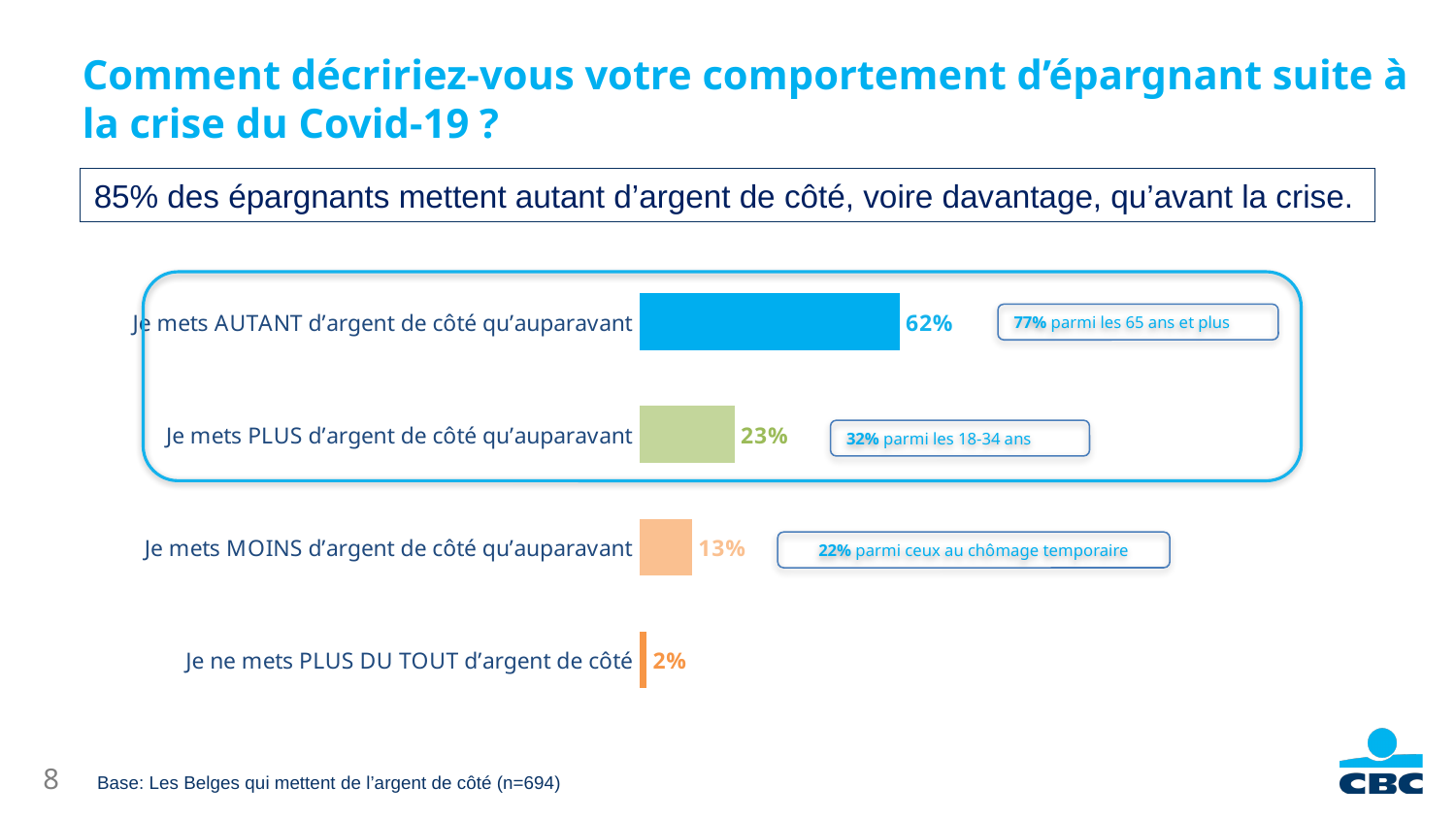
How many categories are shown in the chart? 4 Which category has the lowest value in the chart? Je ne mets PLUS DU TOUT d'argent de côté Which is larger: the share who put LESS money aside than before, or the share who no longer put any money aside at all? Je mets MOINS d'argent de côté qu'auparavant What is the difference between the share who put MORE aside (23%) and the share who put LESS aside (13%)? 10% What percentage of savers say they put LESS money aside than before ("Je mets MOINS d'argent de côté qu'auparavant")? 13% What is the difference between the share who put the SAME amount aside (62%) and the share who put MORE aside (23%)? 39% Which category has the highest value in the chart? Je mets AUTANT d'argent de côté qu'auparavant According to the annotation next to the top bar, what percentage of those aged 65 and over put the same amount of money aside as before? 77% What percentage of savers say they put MORE money aside than before ("Je mets PLUS d'argent de côté qu'auparavant")? 23% What percentage of savers say they no longer put any money aside at all ("Je ne mets PLUS DU TOUT d'argent de côté")? 2% What kind of chart is shown on the slide? Bar chart What percentage of savers say they put the SAME amount of money aside as before ("Je mets AUTANT d'argent de côté qu'auparavant")? 62%